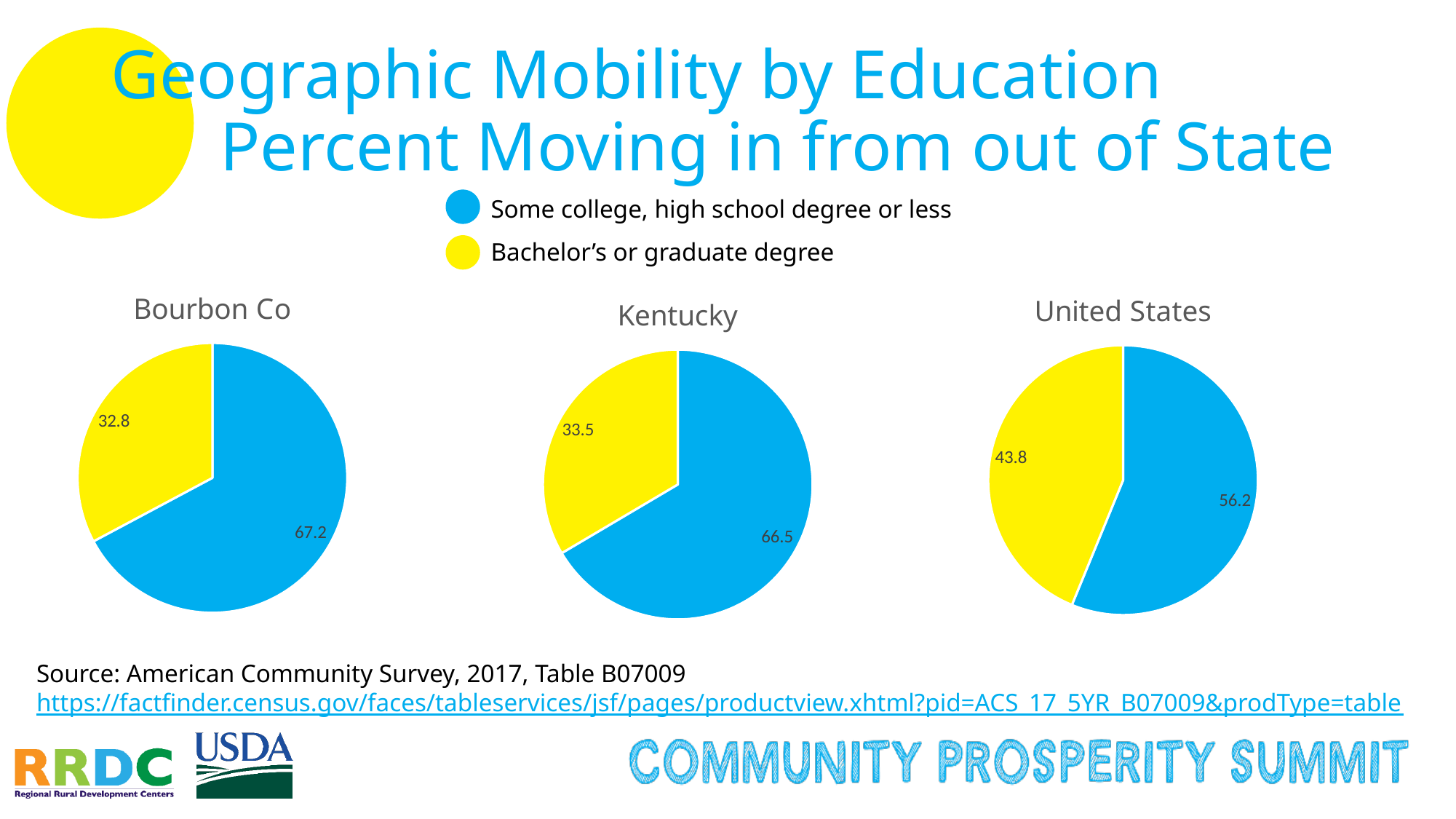
In the Kentucky pie chart, what is the value for Bachelor's or graduate degree? 33.5 In the Bourbon Co pie chart, what is the difference between the Some college, high school degree or less slice and the Bachelor's or graduate degree slice? 34.4 In the Bourbon Co pie chart, what is the value for Some college, high school degree or less? 67.2 In the Bourbon Co pie chart, what is the value for Bachelor's or graduate degree? 32.8 In the United States pie chart, which slice is larger: Some college, high school degree or less, or Bachelor's or graduate degree? Some college, high school degree or less In the United States pie chart, what is the value for Some college, high school degree or less? 56.2 How many categories does the legend list? 2 In the Kentucky pie chart, what is the value for Some college, high school degree or less? 66.5 How many pie charts are shown on the slide? 3 In the United States pie chart, what is the value for Bachelor's or graduate degree? 43.8 In the Kentucky pie chart, what is the difference between the Some college, high school degree or less slice and the Bachelor's or graduate degree slice? 33 What kind of chart is used for Bourbon Co, Kentucky and United States on this slide? Pie chart